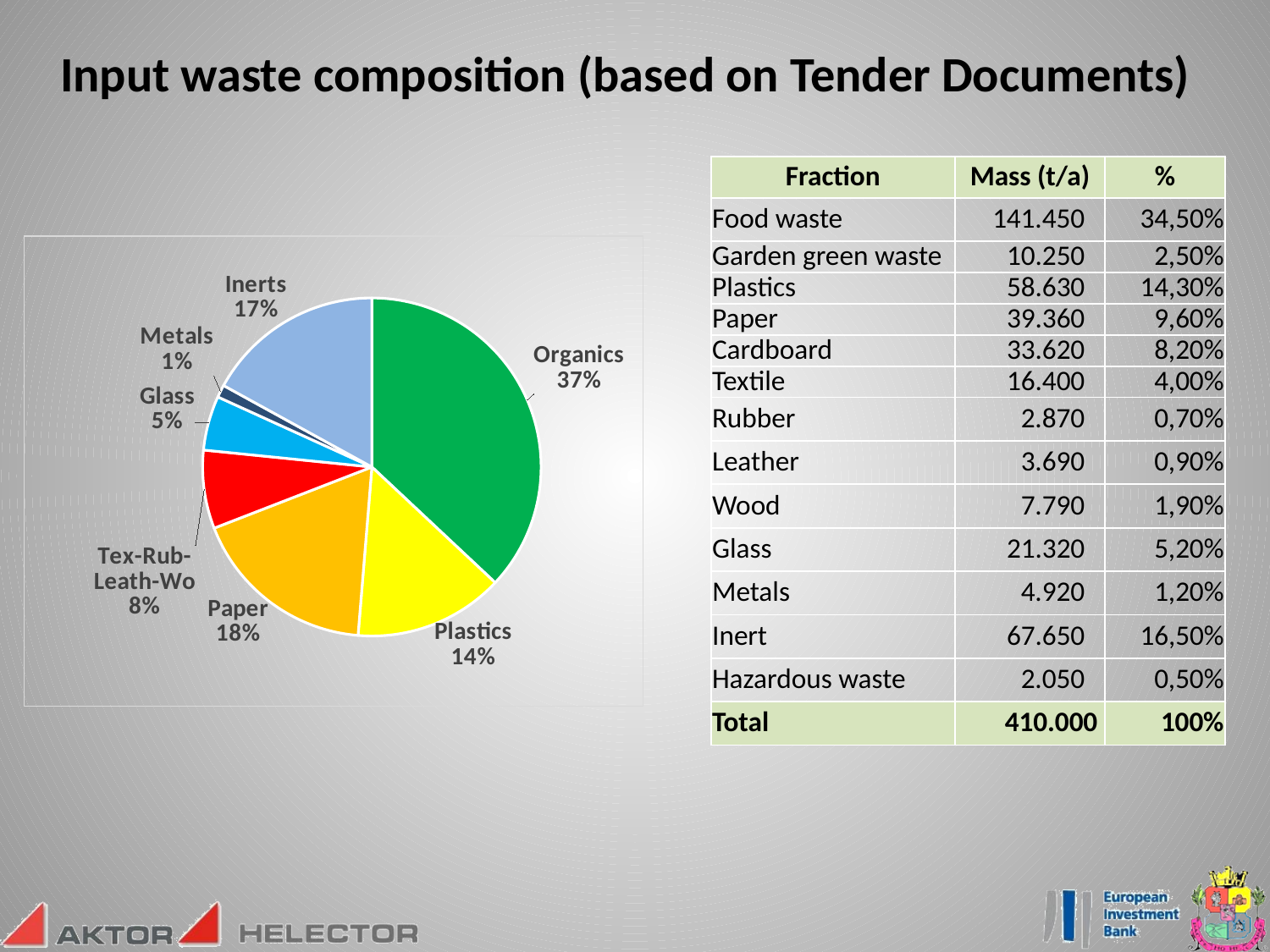
What kind of chart is shown on the slide? pie chart What share of the pie does Organics represent? 37% What is the combined share of Organics and Inerts in the pie chart? 54% What percentage is shown for Tex-Rub-Leath-Wo in the pie chart? 8% What percentage is shown for Inerts in the pie chart? 17% Which slice of the pie chart is the largest? Organics How many slices does the pie chart have? 7 What percentage is shown for Paper in the pie chart? 18% What is the difference in percentage points between Paper and Plastics in the pie chart? 4 What is the title of the slide containing the pie chart? Input waste composition (based on Tender Documents) Which is larger in the pie chart, Glass or Metals? Glass Which slice of the pie chart is the smallest? Metals